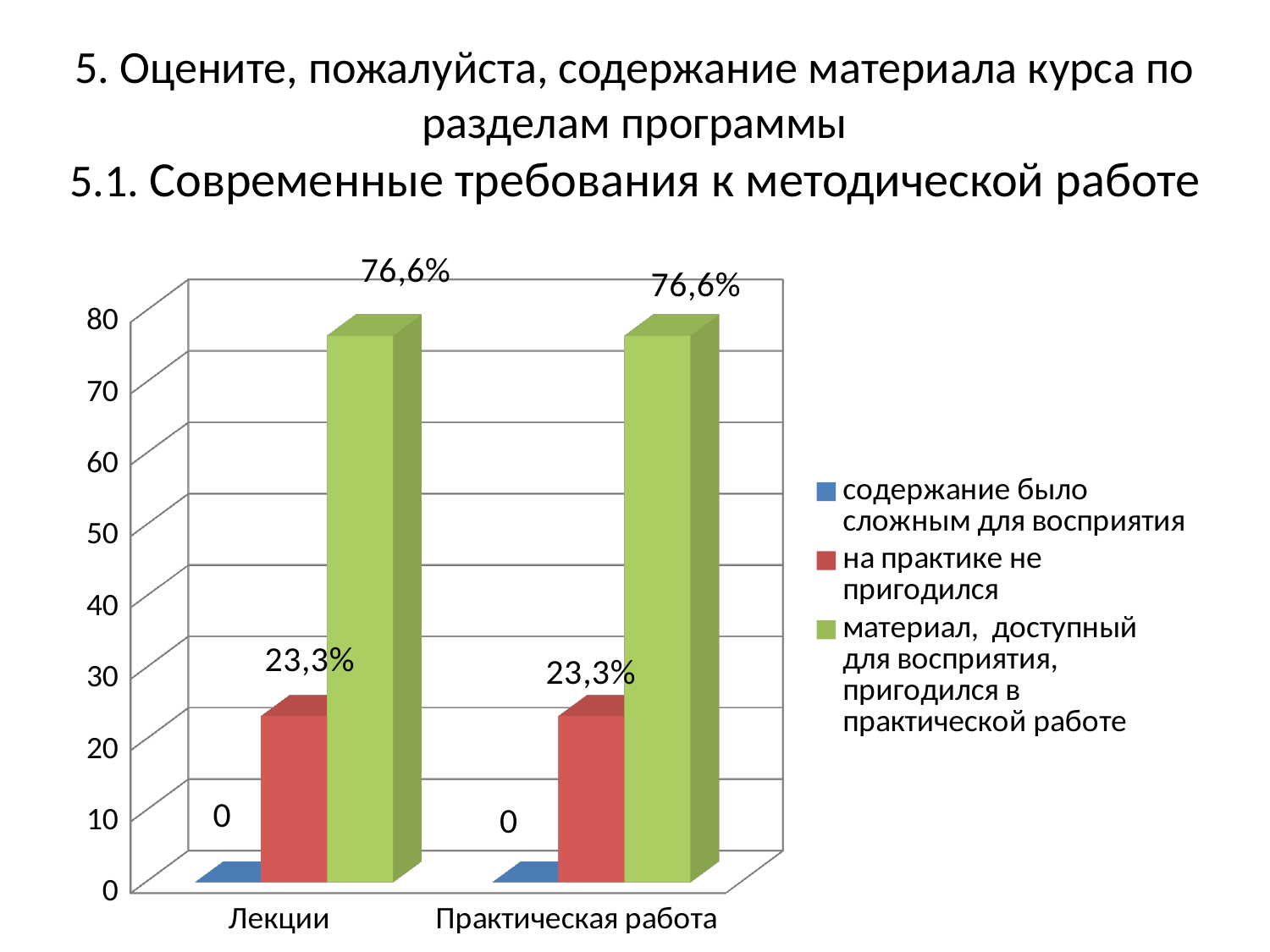
How many categories are shown on the x axis? 2 What value is shown for 'на практике не пригодился' in the 'Практическая работа' category? 23,3% Is the value for 'на практике не пригодился' in the 'Практическая работа' category greater or less than 30? less What value is shown for 'материал, доступный для восприятия, пригодился в практической работе' in the 'Лекции' category? 76,6% What value is shown for 'на практике не пригодился' in the 'Лекции' category? 23,3% What colour represents the series 'на практике не пригодился'? red What kind of chart is shown on the slide? bar chart How many series does the legend list? 3 Which is larger in the 'Лекции' category: 'на практике не пригодился' or 'материал, доступный для восприятия, пригодился в практической работе'? материал, доступный для восприятия, пригодился в практической работе Which series has the lowest value in the 'Лекции' category? содержание было сложным для восприятия Which series has the highest value in the 'Практическая работа' category? материал, доступный для восприятия, пригодился в практической работе What value is shown for 'содержание было сложным для восприятия' in the 'Лекции' category? 0